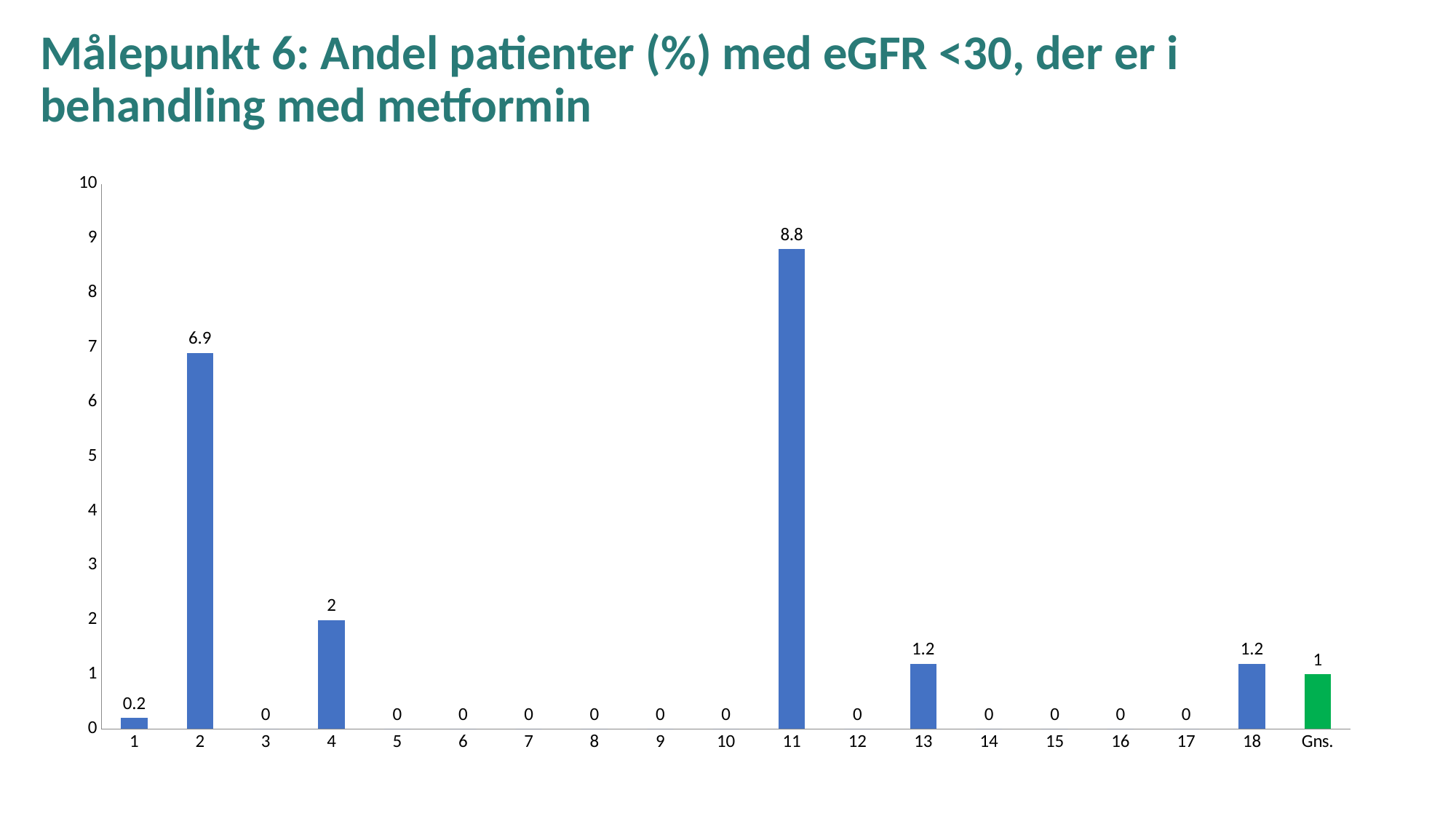
Which is larger, the value for category 4 or the value for category 13? 4 What is the value for category 11? 8.8 What is the value for category 2? 6.9 Which bar is coloured green? Gns. What is the value for category 4? 2 Is the value for category 2 greater or less than 5? greater How many categories have a value of 0? 12 What is the difference between the values for category 11 and category 2? 1.9 How many categories are shown on the x axis? 19 What is the value for Gns.? 1 Which category has the highest value? 11 What kind of chart is shown on the slide? bar chart